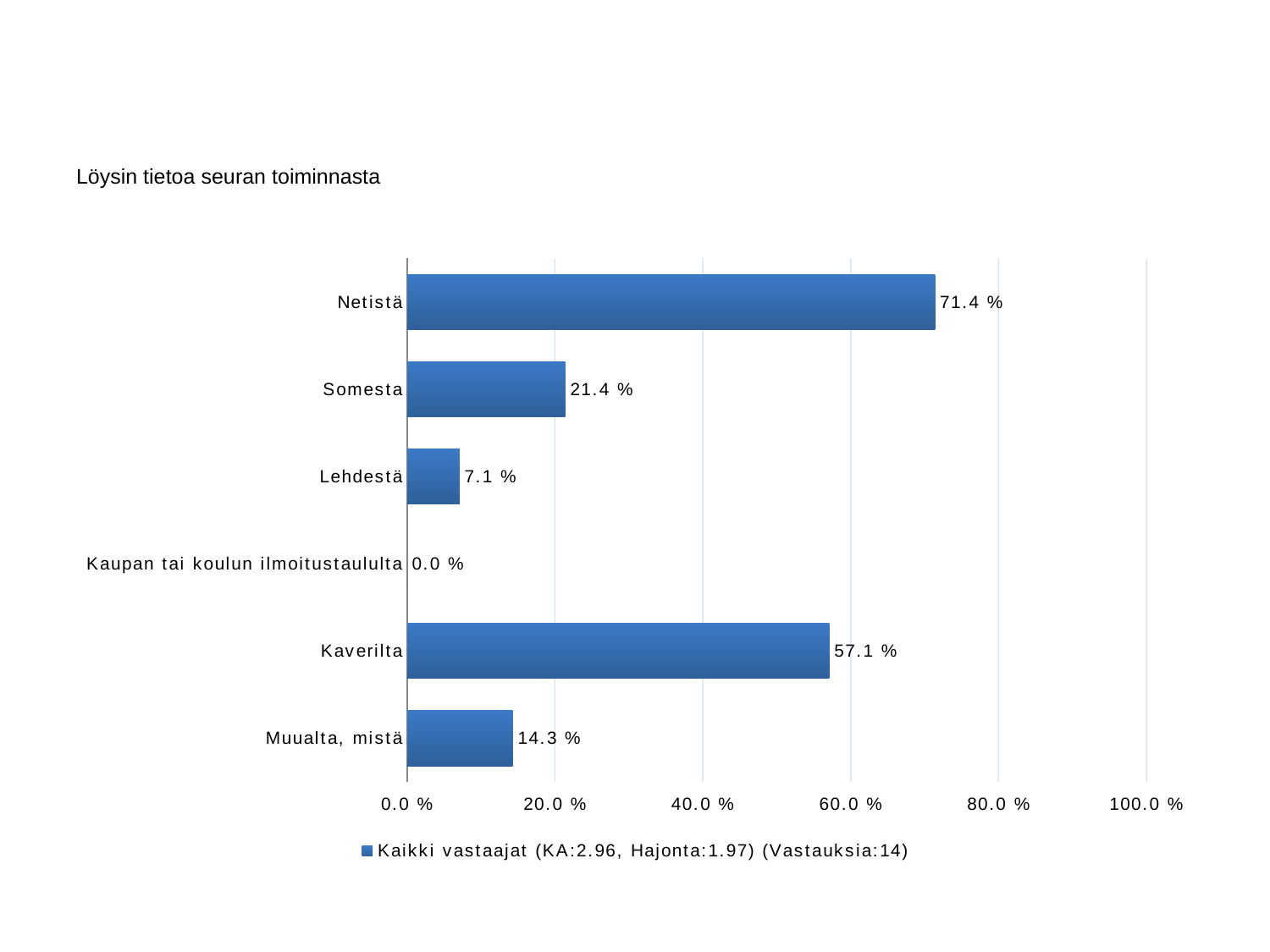
Is the value for Kaverilta greater or less than 40.0 %? greater Which is larger, the value for Somesta or the value for Muualta, mistä? Somesta Which category has the highest value? Netistä What is the difference between the values for Netistä and Kaverilta? 14.3 % What is the title of the chart? Löysin tietoa seuran toiminnasta What is the value for Kaverilta? 57.1 % What is the value for Netistä? 71.4 % What kind of chart is shown on the slide? bar chart Which category has the lowest value? Kaupan tai koulun ilmoitustaululta How many categories are shown in the chart? 6 What is the value for Kaupan tai koulun ilmoitustaululta? 0.0 % What is the value for Lehdestä? 7.1 %